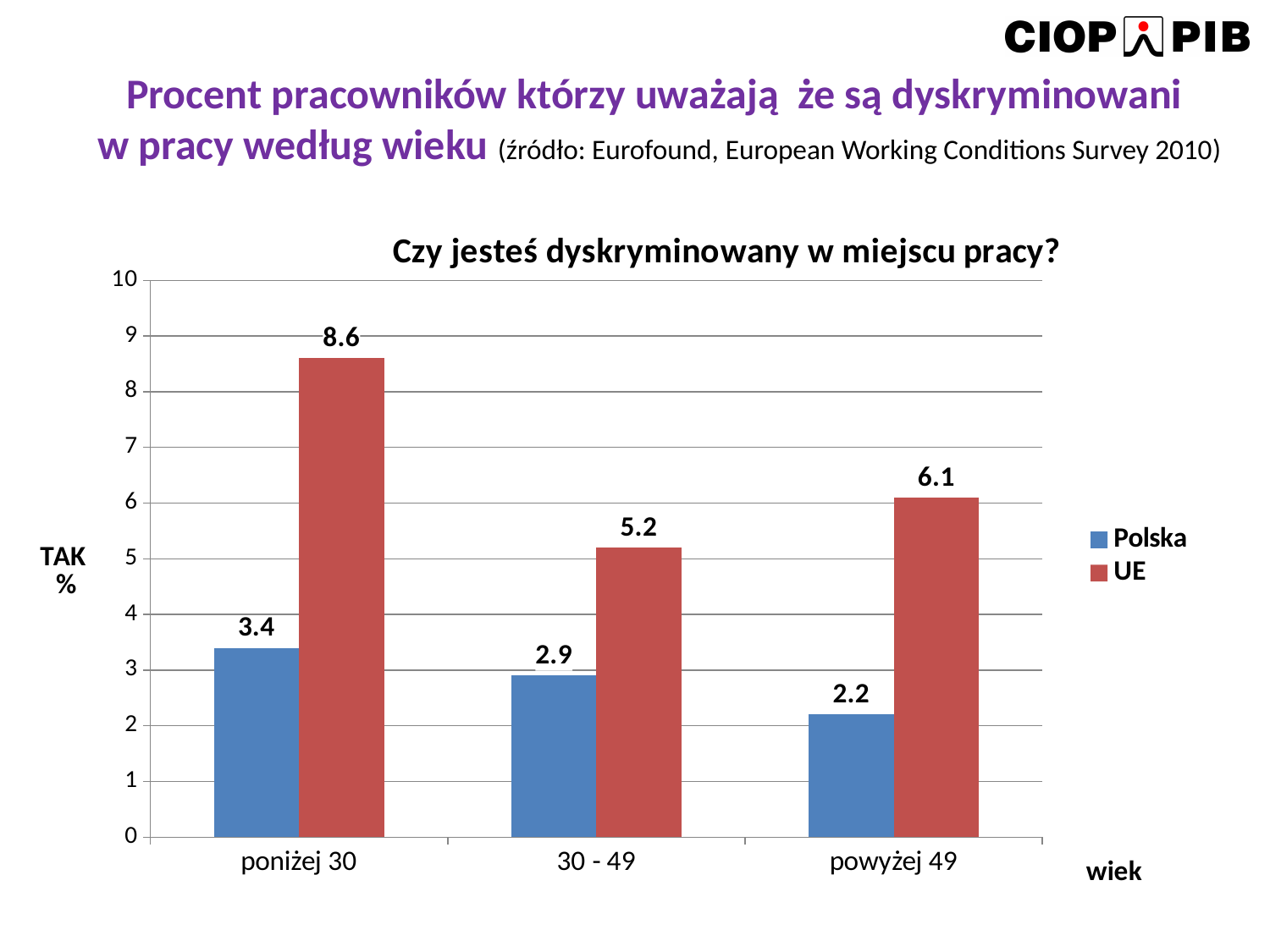
What is the value for UE in the 'powyżej 49' age group? 6.1 What is the value for UE in the '30 - 49' age group? 5.2 What is the value for Polska in the 'poniżej 30' age group? 3.4 What is the difference between the UE and Polska values for the 'poniżej 30' age group? 5.2 How many age groups are shown on the x axis? 3 Which is larger in the '30 - 49' age group, Polska or UE? UE What kind of chart is shown on the slide? bar chart How many series does the legend list? 2 Do the Polska values rise or fall as age increases along the x axis? fall What is the difference between the Polska values for 'poniżej 30' and 'powyżej 49'? 1.2 Which age group has the highest value for UE? poniżej 30 Which age group has the lowest value for Polska? powyżej 49